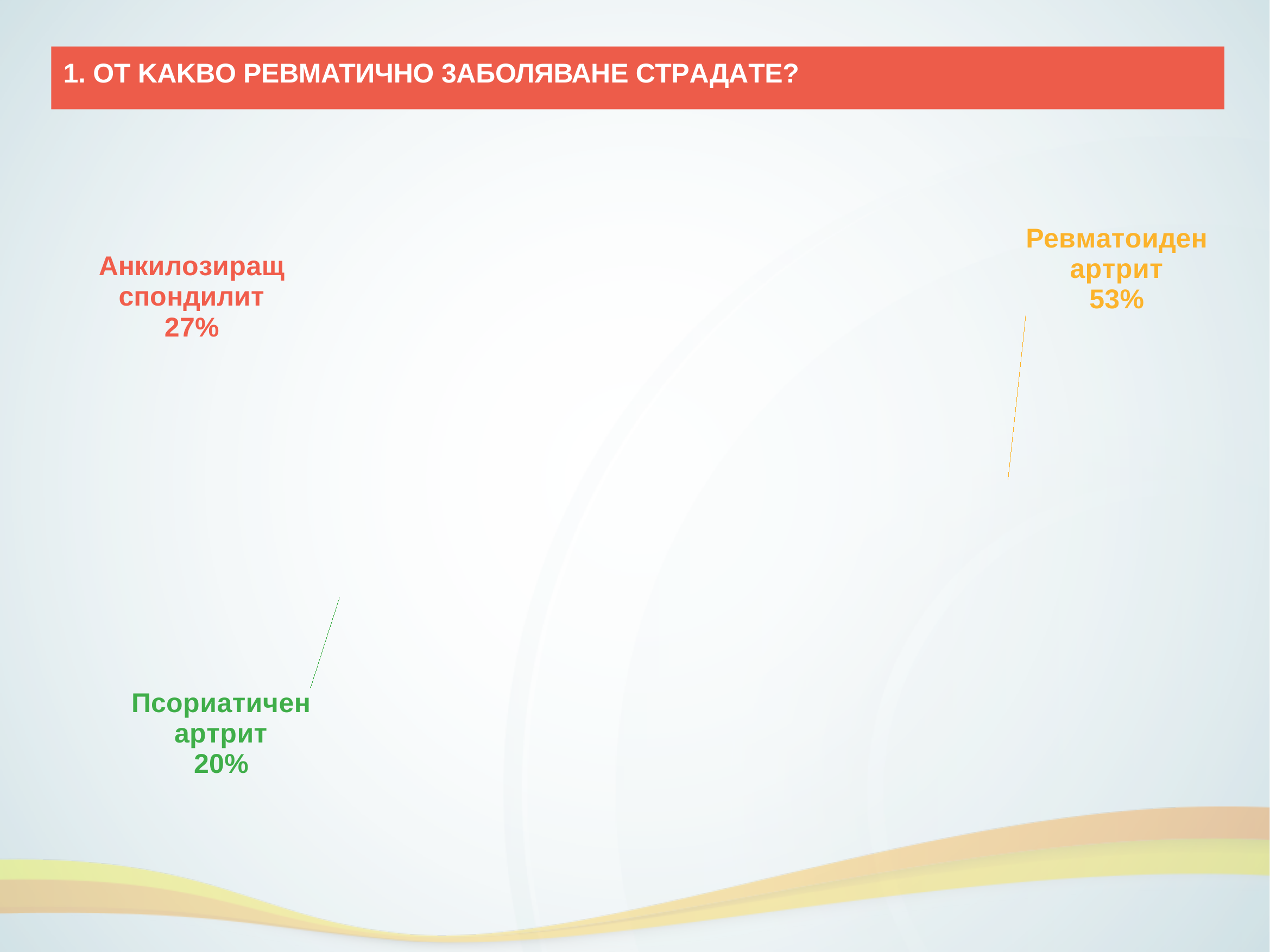
How many disease categories are labelled on the chart? 3 In what colour is the label for Псориатичен артрит written? Green Which rheumatic disease has the highest share on the chart? Ревматоиден артрит What percentage is shown for Псориатичен артрит? 20% Which has a larger share: Анкилозиращ спондилит or Псориатичен артрит? Анкилозиращ спондилит Which rheumatic disease has the lowest share on the chart? Псориатичен артрит What percentage is shown for Анкилозиращ спондилит? 27% What percentage of respondents suffer from Ревматоиден артрит? 53% What is the title of the slide containing the chart? 1. ОТ КАКВО РЕВМАТИЧНО ЗАБОЛЯВАНЕ СТРАДАТЕ? Which has a larger share: Ревматоиден артрит or Псориатичен артрит? Ревматоиден артрит What is the difference in percentage points between Анкилозиращ спондилит and Псориатичен артрит? 7 What is the difference in percentage points between Ревматоиден артрит and Анкилозиращ спондилит? 26